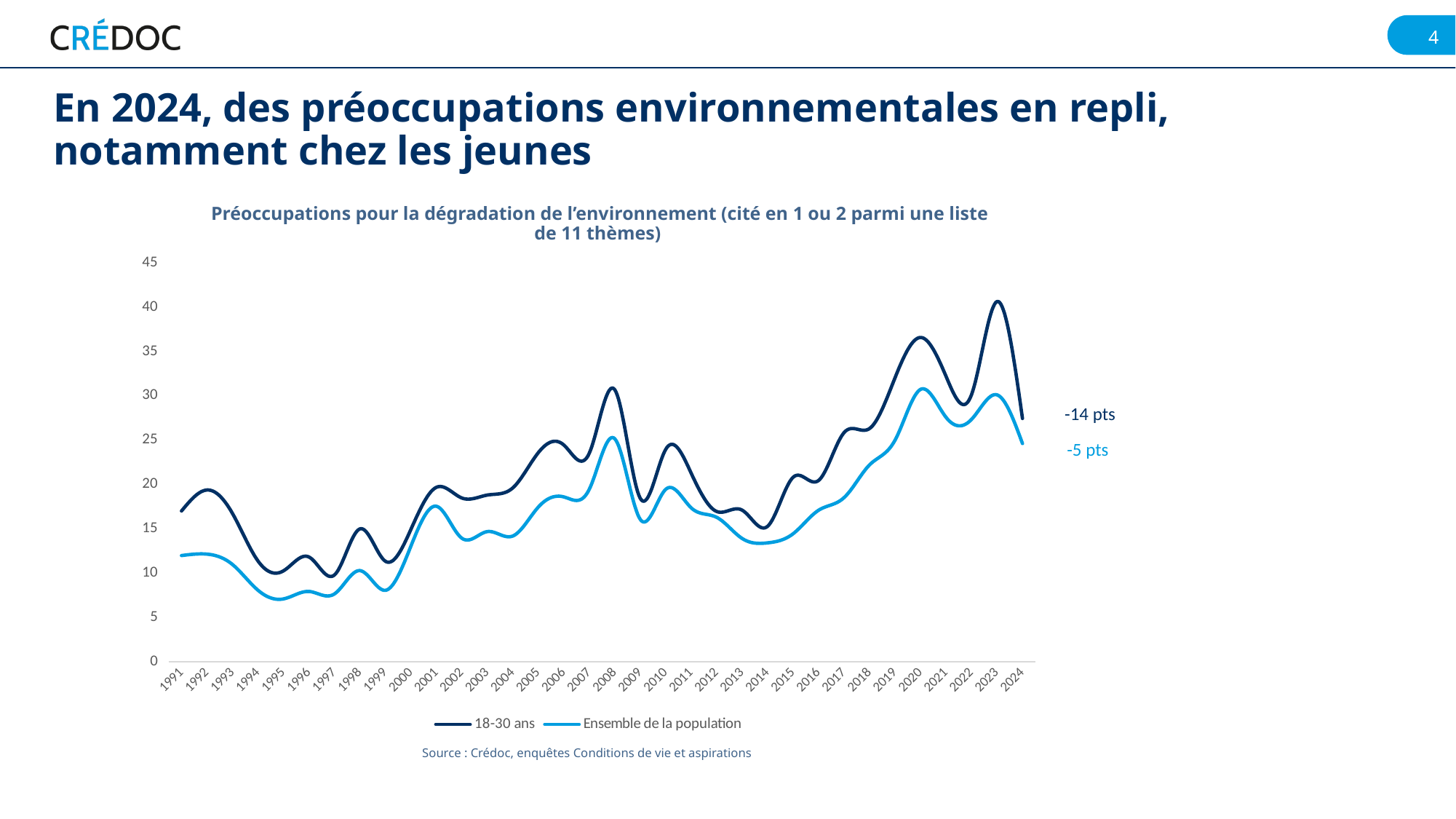
In which year does the 18-30 ans series reach its highest value? 2023 What is the first year shown on the x axis? 1991 How many years are plotted along the x axis, from 1991 to 2024? 34 What change in points is annotated next to the 18-30 ans line at the end of the series? -14 pts How many series does the legend list? 2 Is the value for 18-30 ans in 2023 greater or less than 35? greater Is the value for Ensemble de la population in 2024 greater or less than 30? less Is the value for 18-30 ans in 2008 greater or less than 25? greater What kind of chart is shown on the slide? Line chart In 2023, which series has the higher value, 18-30 ans or Ensemble de la population? 18-30 ans What are the two series named in the legend? 18-30 ans and Ensemble de la population